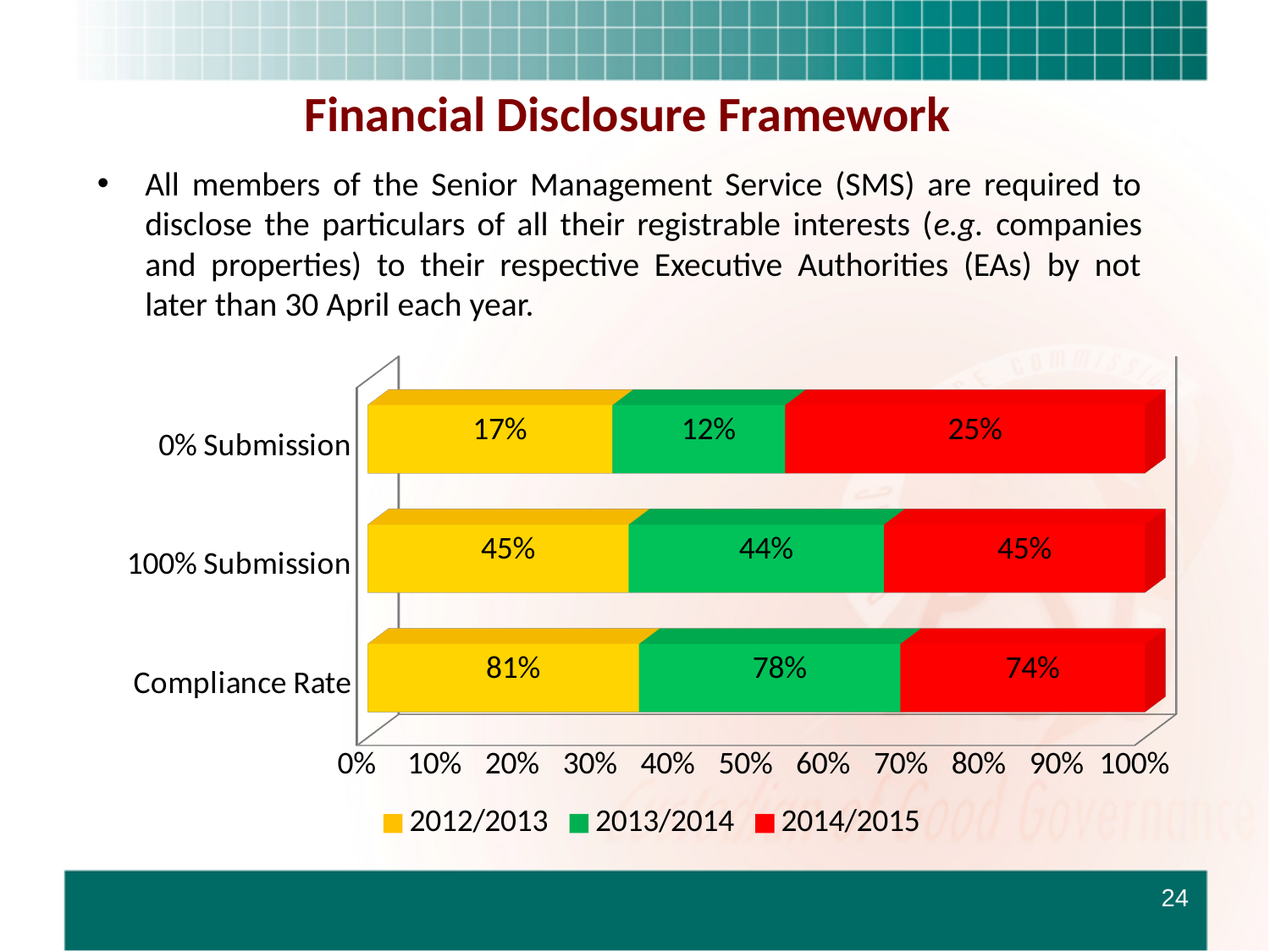
Which is larger, the 0% Submission value for 2012/2013 or for 2014/2015? 2014/2015 How many series does the legend list? 3 What kind of chart is shown on the slide? Stacked bar chart What is the Compliance Rate for 2014/2015? 74% Which year has the highest Compliance Rate? 2012/2013 What is the Compliance Rate for 2012/2013? 81% What is the value for 100% Submission in 2013/2014? 44% Which year has the lowest value for 0% Submission? 2013/2014 How many categories are shown on the vertical axis? 3 What is the difference between the 0% Submission values for 2014/2015 and 2013/2014? 13% What is the value for 0% Submission in 2014/2015? 25% What is the difference between the Compliance Rate for 2012/2013 and 2014/2015? 7%